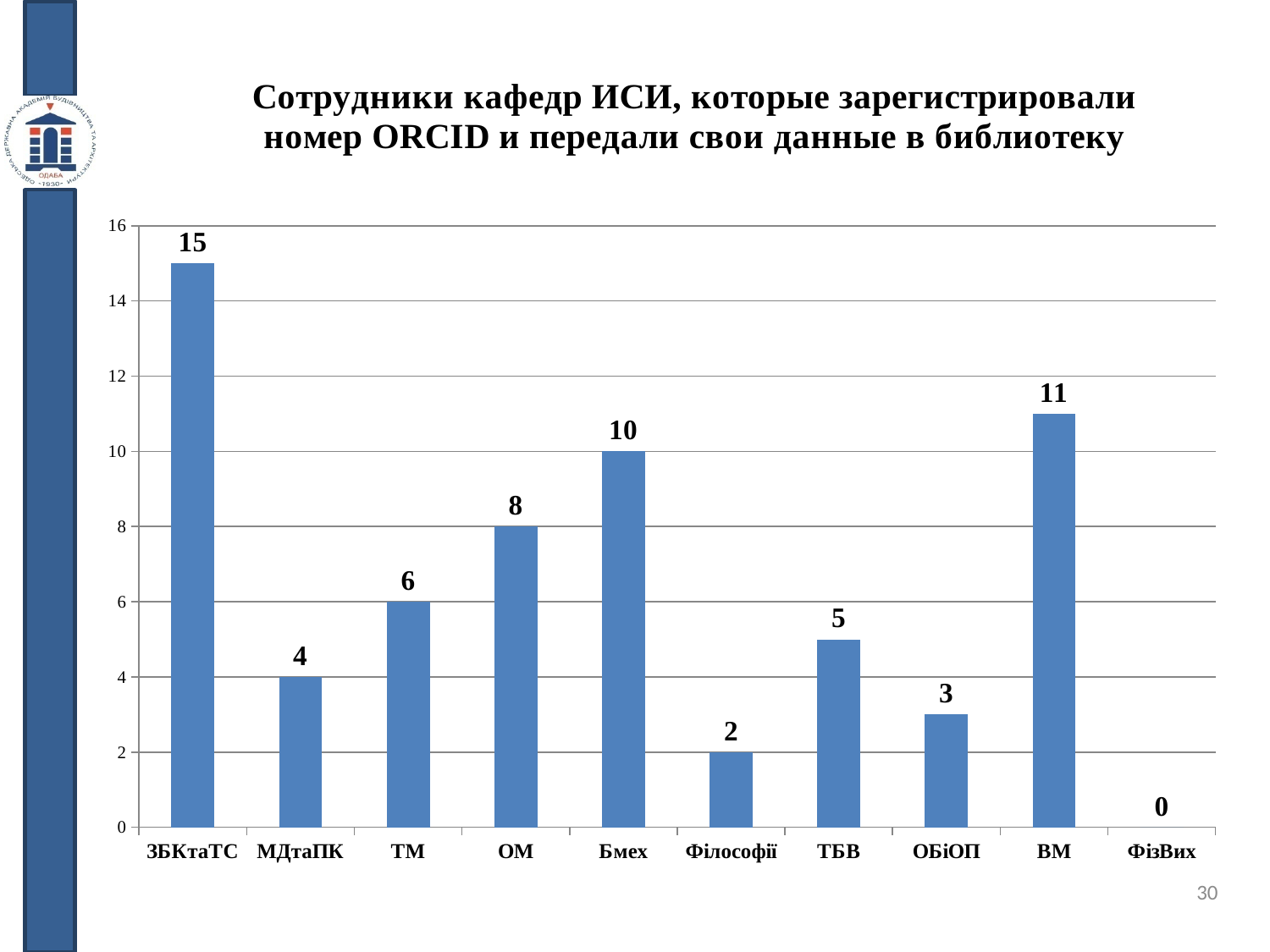
How many categories are shown on the x axis? 10 What is the value for ЗБКтаТС? 15 Which is larger, the value for ОМ or the value for ТМ? ОМ Is the value for ОБіОП greater or less than 4? less What is the value for Бмех? 10 Which category has the lowest value? ФізВих What is the difference between the values for ВМ and ТБВ? 6 What kind of chart is shown on the slide? bar chart Which category has the highest value? ЗБКтаТС What is the value for ФізВих? 0 What is the value for Філософії? 2 What is the maximum value shown on the y axis? 16